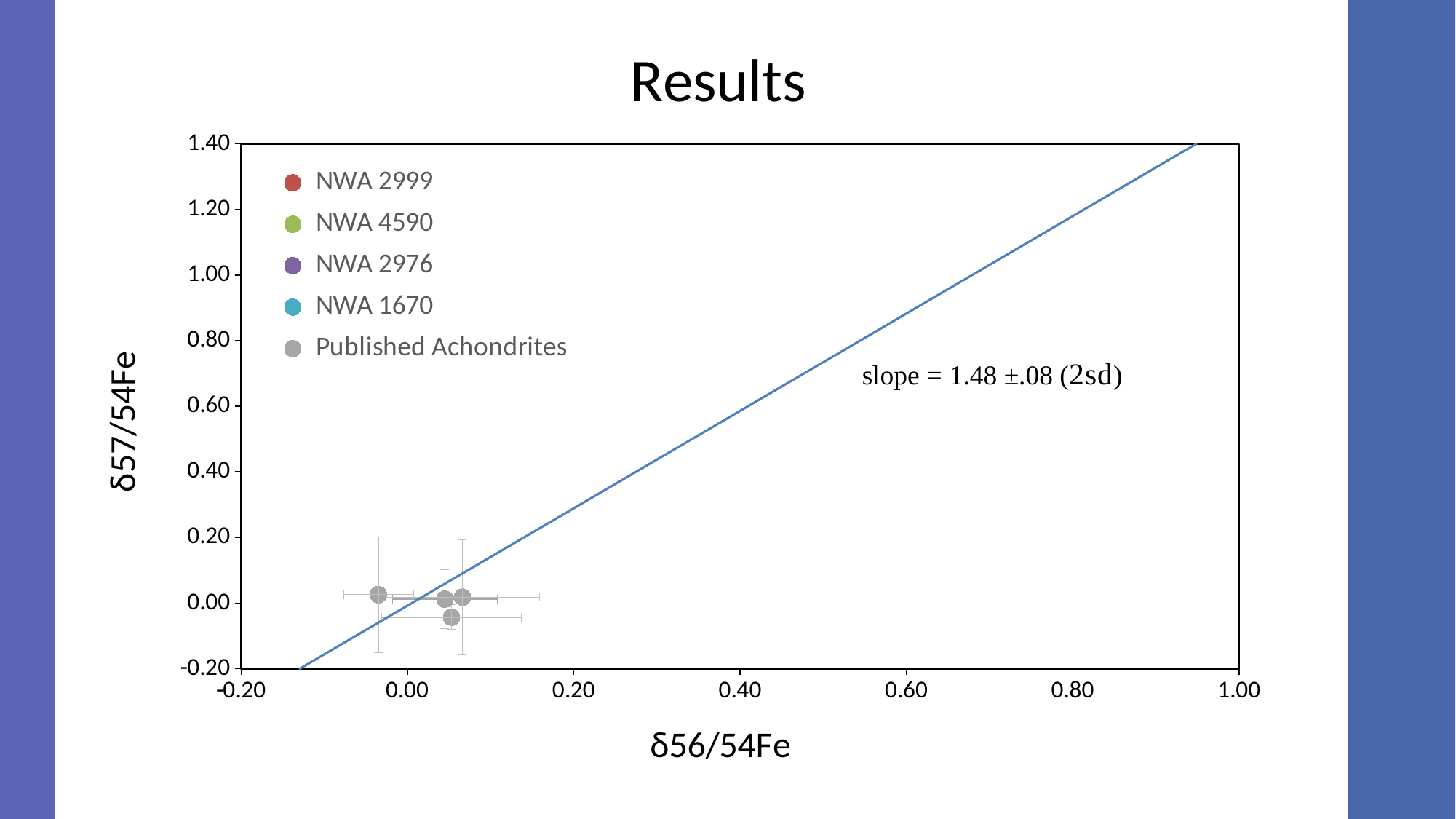
How many series does the legend list? 5 What is the label of the x axis? δ56/54Fe Does the fitted line rise or fall as δ56/54Fe increases? rise What kind of chart is shown on the slide? scatter chart Are the δ56/54Fe values of the Published Achondrites points greater or less than 0.20? less What slope is printed on the chart for the fitted line? 1.48 ±.08 (2sd) How many Published Achondrites data points are plotted on the chart? 4 What is the lowest value shown on the x axis? -0.20 Which legend entry is shown in gray? Published Achondrites What is the title of the chart? Results What is the highest value shown on the y axis? 1.40 Are the δ57/54Fe values of the Published Achondrites points greater or less than 0.20? less